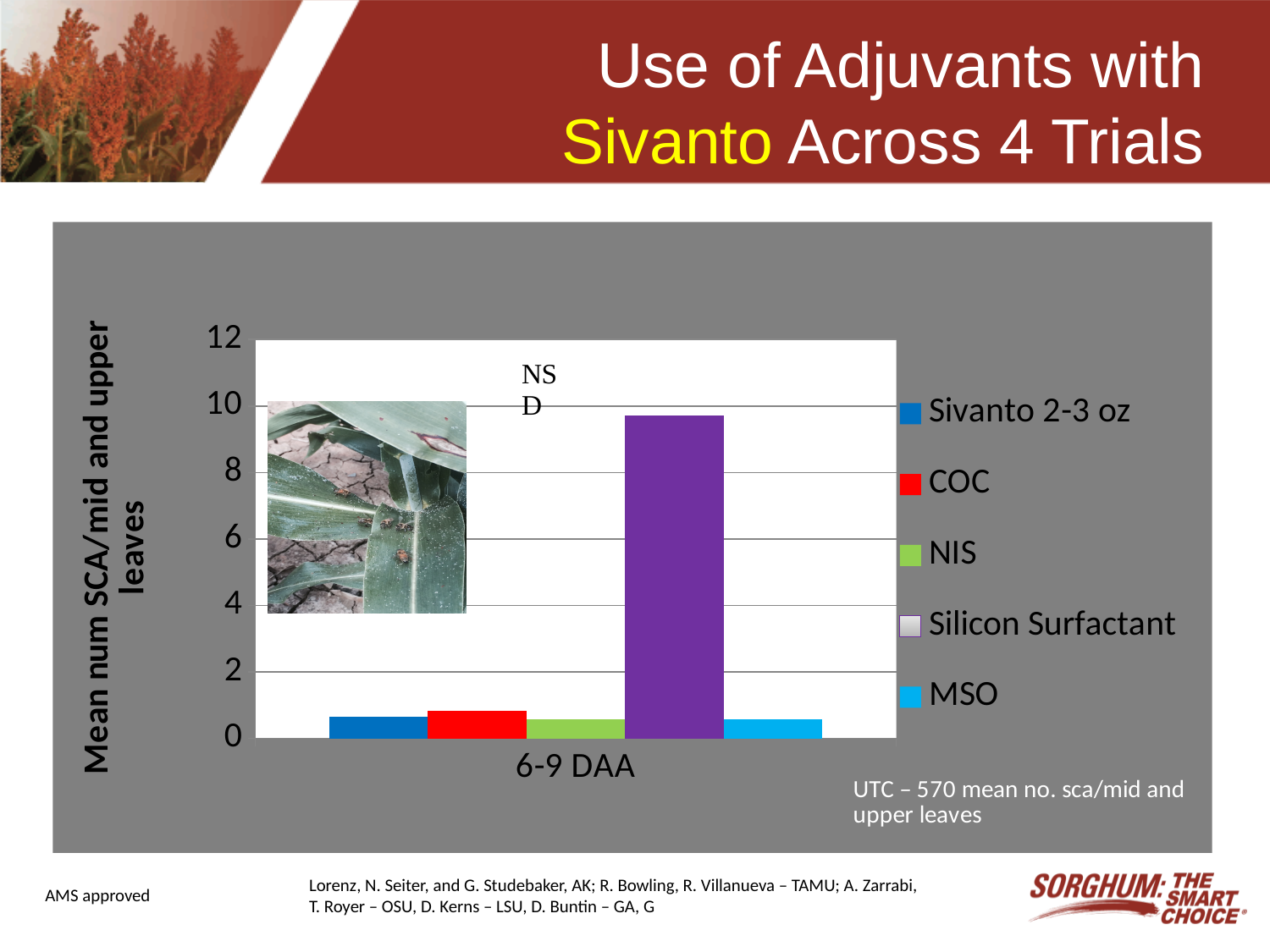
Is the value for Silicon Surfactant greater or less than 8? greater What is the first entry listed in the chart legend? Sivanto 2-3 oz How many series does the chart legend list? 5 Which is larger, the value for Silicon Surfactant or the value for COC? Silicon Surfactant Which is larger, the value for COC or the value for NIS? COC How many categories are shown on the x axis of the chart? 1 Is the value for Silicon Surfactant greater or less than 10? less What is the category label on the x axis of the chart? 6-9 DAA Is the value for Sivanto 2-3 oz greater or less than 2? less What kind of chart is shown on the slide? bar chart Which series has the tallest bar in the chart? Silicon Surfactant